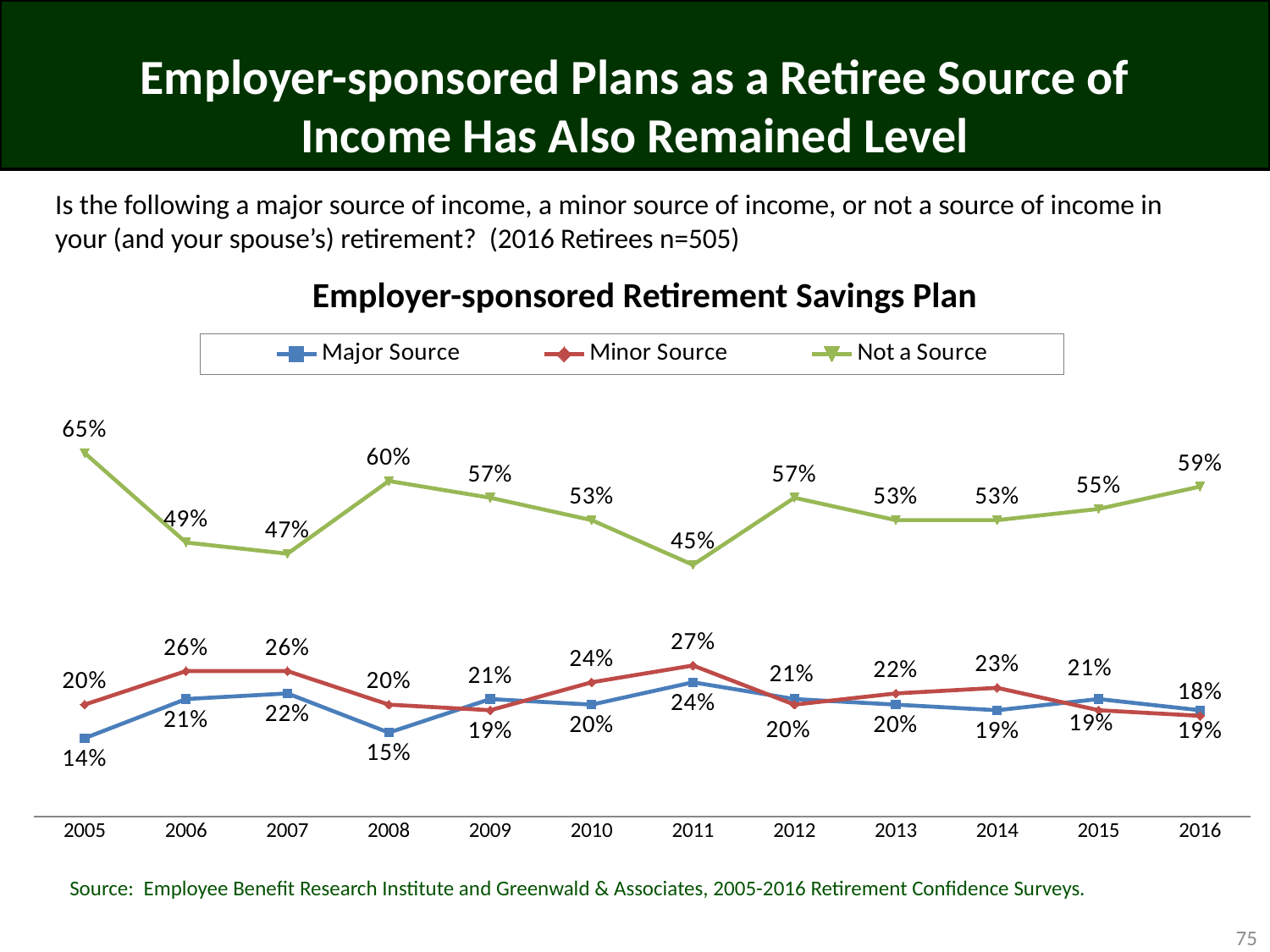
Which year has the larger Not a Source value, 2008 or 2009? 2008 What is the value for Major Source in 2005? 14% In which year is the Not a Source value lowest? 2011 What is the value for Not a Source in 2016? 59% What is the difference between the Not a Source values in 2005 and 2011? 20 percentage points How many series does the legend list? 3 Does the Not a Source line rise or fall from 2014 to 2016? Rise What is the value for Not a Source in 2005? 65% What kind of chart is shown on the slide? Line chart In which year is the Not a Source value highest? 2005 What is the value for Minor Source in 2011? 27% How many years are plotted along the x axis? 12